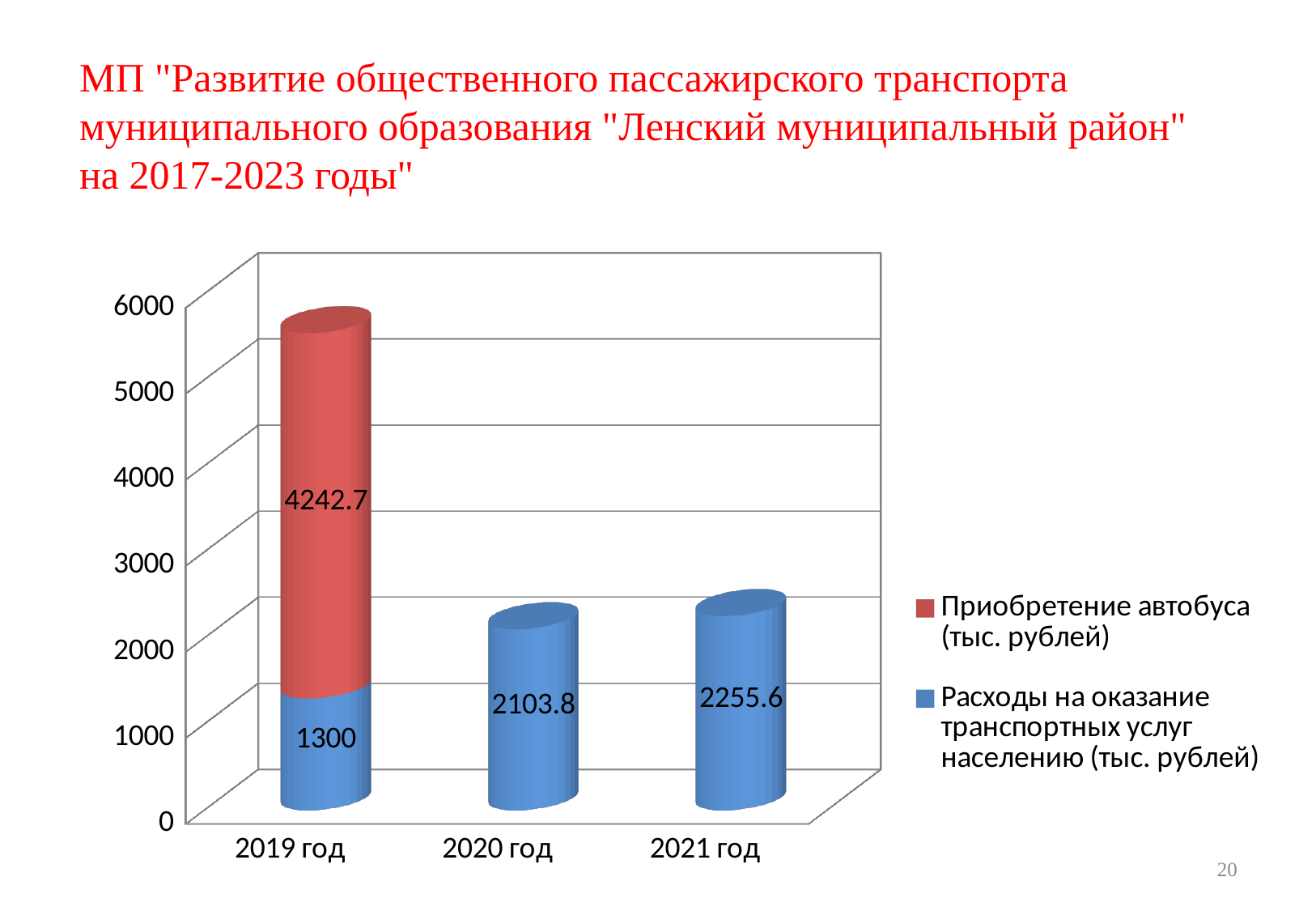
What is the value for "Расходы на оказание транспортных услуг населению (тыс. рублей)" in 2020 год? 2103.8 How many series does the legend list? 2 What is the total of the stacked bar for 2019 год? 5542.7 Which is larger: the "Приобретение автобуса" value in 2019 год or the "Расходы на оказание транспортных услуг населению" value in 2019 год? Приобретение автобуса What is the value for "Приобретение автобуса (тыс. рублей)" in 2019 год? 4242.7 What is the value for "Расходы на оказание транспортных услуг населению (тыс. рублей)" in 2019 год? 1300 How many years are shown on the x axis of the chart? 3 Which year has the lowest value for "Расходы на оказание транспортных услуг населению (тыс. рублей)"? 2019 год Which year has the highest value for "Расходы на оказание транспортных услуг населению (тыс. рублей)"? 2021 год What is the value for "Расходы на оказание транспортных услуг населению (тыс. рублей)" in 2021 год? 2255.6 What kind of chart is shown on the slide? Stacked bar chart What is the difference between the "Расходы на оказание транспортных услуг населению" values for 2021 год and 2020 год? 151.8